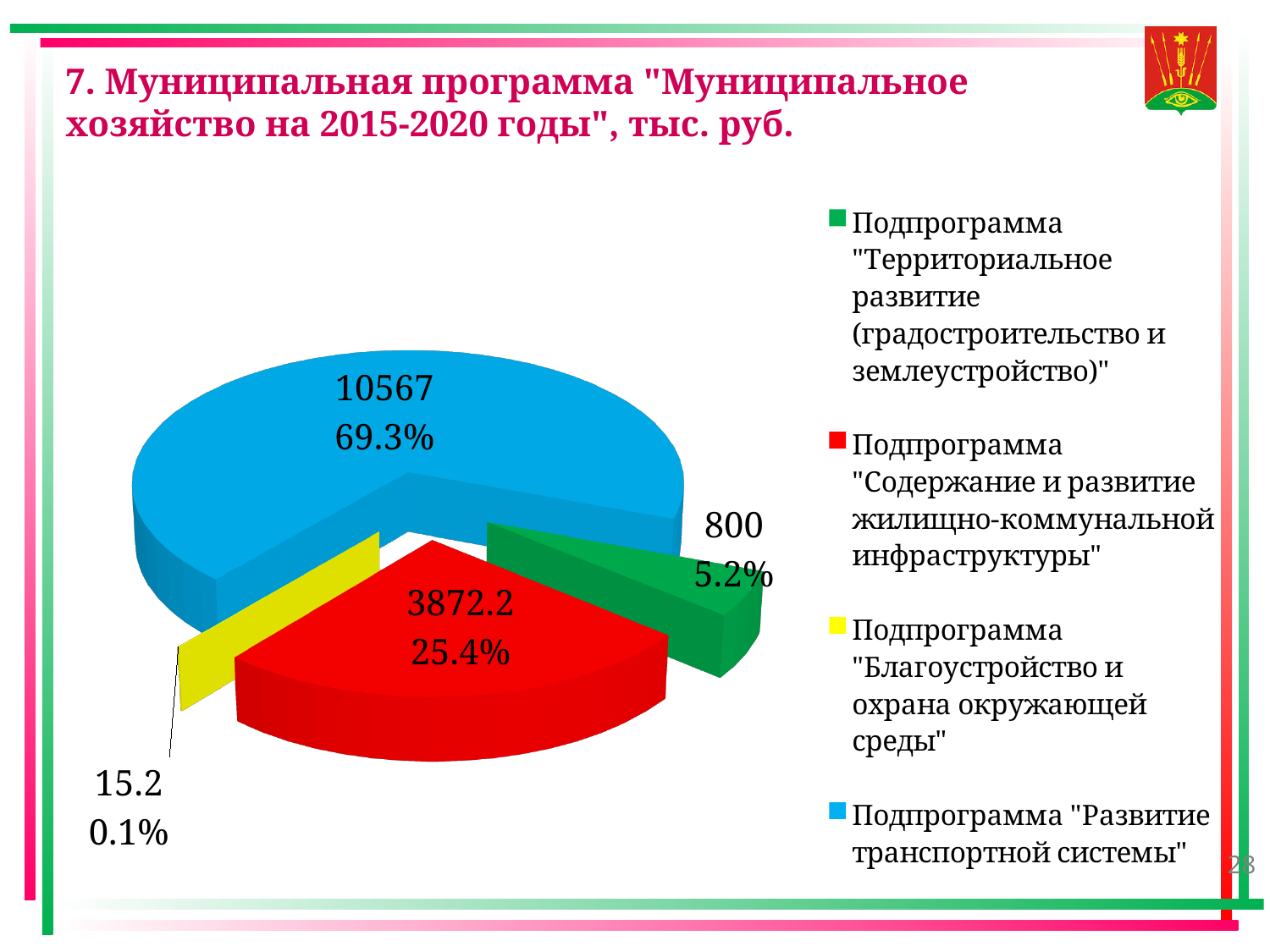
What is the value for Подпрограмма "Содержание и развитие жилищно-коммунальной инфраструктуры"? 3872.2 Which subprogram has the smallest slice? Подпрограмма "Благоустройство и охрана окружающей среды" What kind of chart is shown on the slide? pie chart How many entries does the legend list? 4 How many slices does the pie chart have? 4 Which subprogram has the largest slice? Подпрограмма "Развитие транспортной системы" What is the value for Подпрограмма "Развитие транспортной системы"? 10567 What share of the pie does Подпрограмма "Территориальное развитие (градостроительство и землеустройство)" take? 5.2% What share of the pie does Подпрограмма "Развитие транспортной системы" take? 69.3% What is the difference between the values for Подпрограмма "Содержание и развитие жилищно-коммунальной инфраструктуры" and Подпрограмма "Территориальное развитие (градостроительство и землеустройство)"? 3072.2 What is the value for Подпрограмма "Территориальное развитие (градостроительство и землеустройство)"? 800 What is the value for Подпрограмма "Благоустройство и охрана окружающей среды"? 15.2